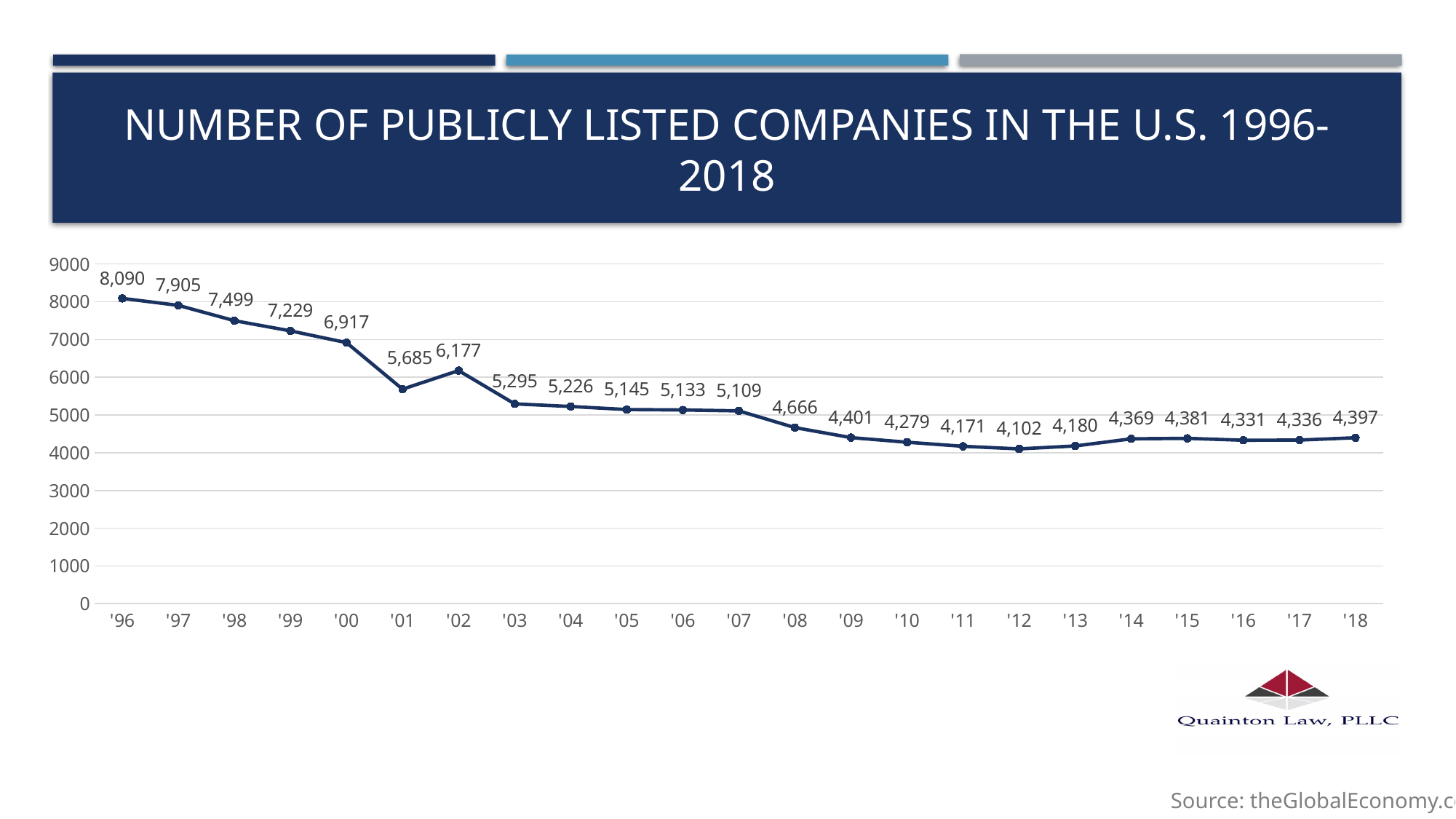
Do the values generally rise or fall from '96 to '12? fall What kind of chart is shown on the slide? line chart Is the value for '08 greater or less than 5000? less Which year has the highest number of publicly listed companies? '96 What is the number of publicly listed companies in '96? 8,090 How many years are plotted on the x axis? 23 Which is larger, the value for '01 or the value for '02? '02 What is the difference between the values for '96 and '18? 3,693 Which year has the lowest number of publicly listed companies? '12 What is the difference between the values for '00 and '01? 1,232 What is the value shown for '12? 4,102 What is the value shown for '02? 6,177